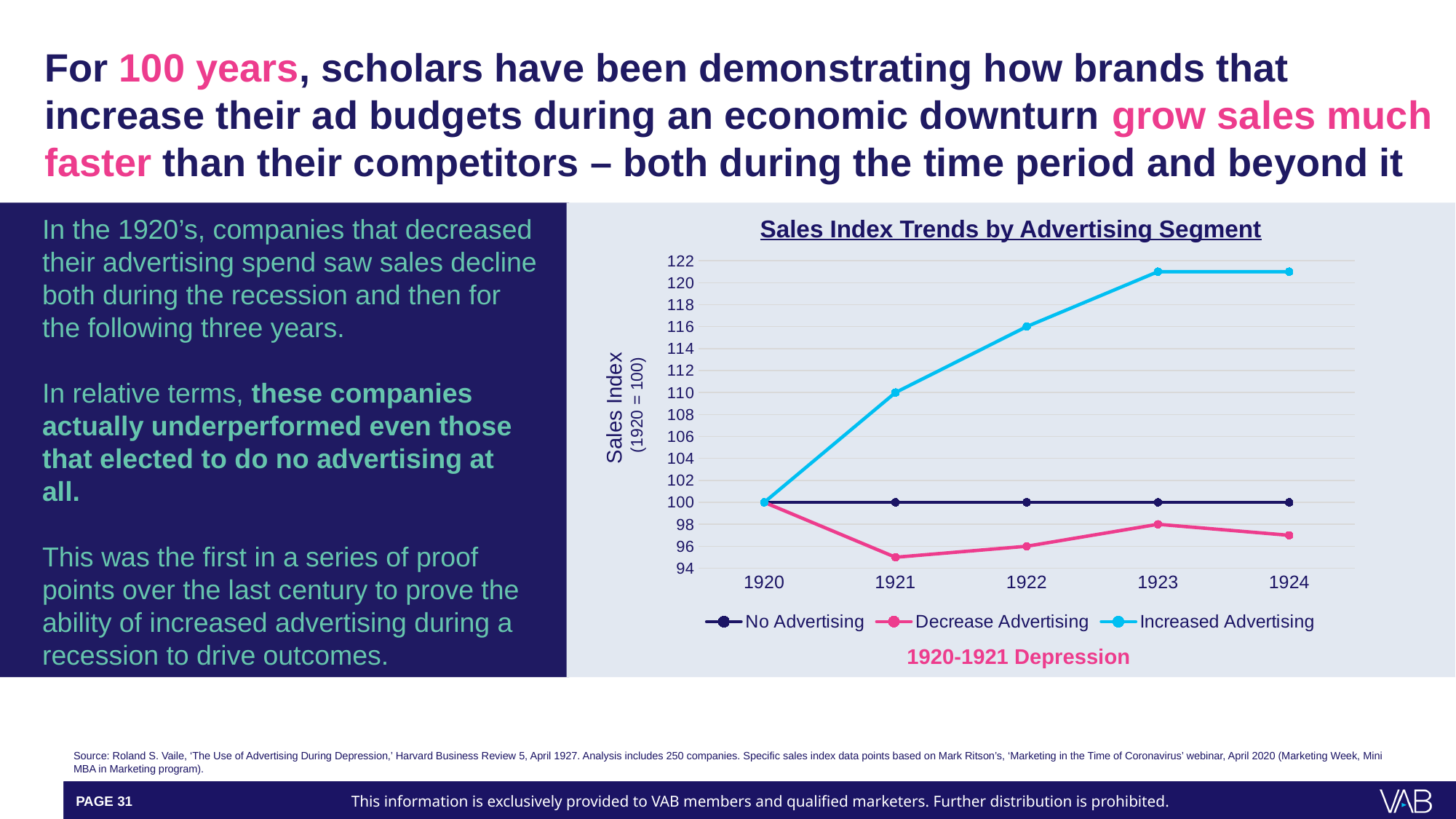
Which advertising segment has the highest Sales Index in 1924? Increased Advertising What type of chart is shown on the slide? Line chart What is the difference between the Increased Advertising and Decrease Advertising Sales Index values in 1922? 20 How many series does the chart legend list? 3 Does the Sales Index for Increased Advertising rise or fall from 1920 to 1923? Rise Is the Sales Index value for Decrease Advertising in 1921 greater or less than 96? less What is the Sales Index value for No Advertising in 1924? 100 What is the Sales Index value for Increased Advertising in 1921? 110 What is the Sales Index value for Increased Advertising in 1922? 116 What is the Sales Index value for Decrease Advertising in 1923? 98 How many years are plotted along the x axis of the chart? 5 Is the Sales Index value for Increased Advertising in 1923 greater or less than 120? greater